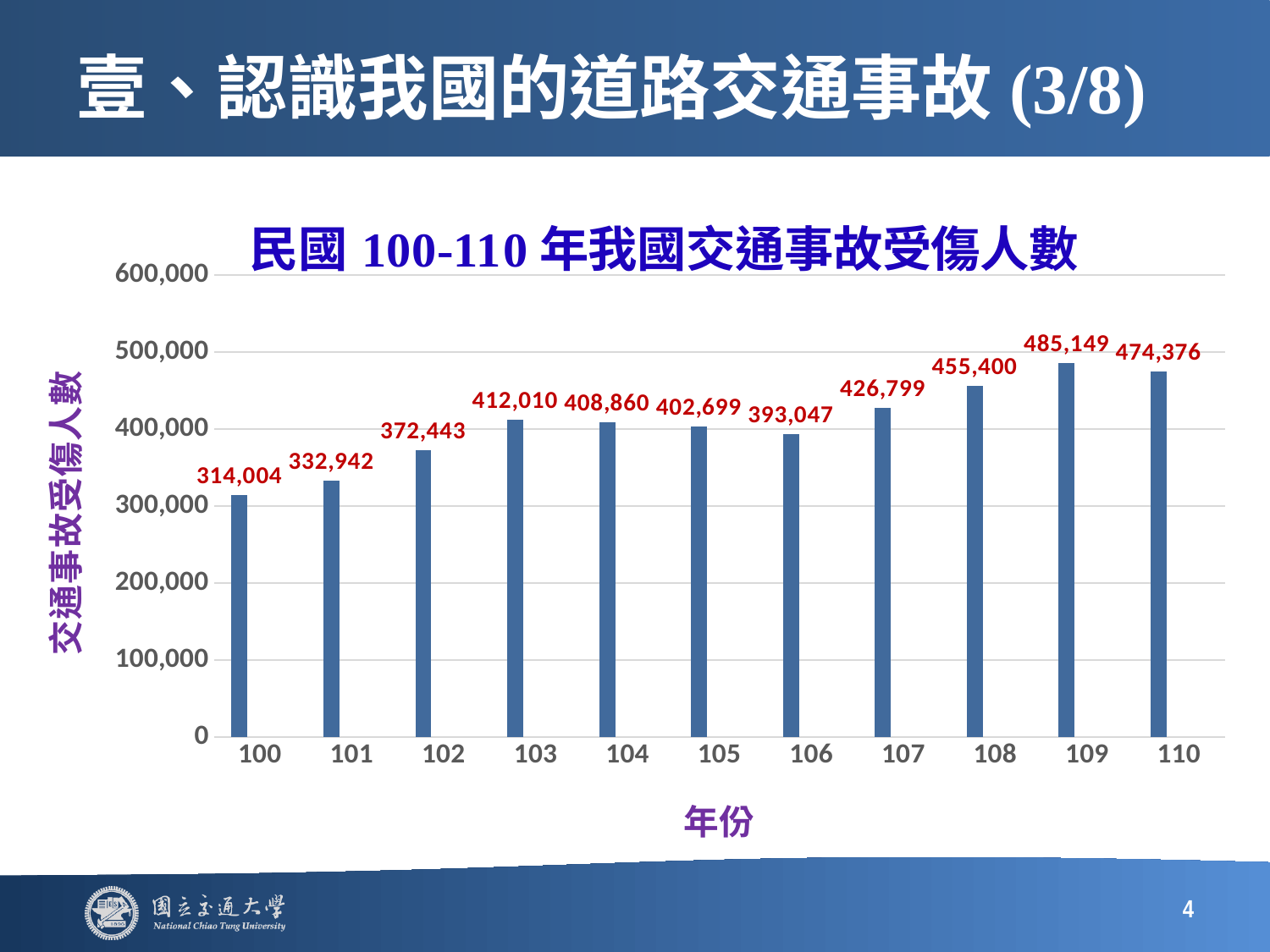
What is the title of the chart? 民國 100-110 年我國交通事故受傷人數 What is the difference in injuries between year 101 and year 100? 18,938 Which year has more injuries, 103 or 104? 103 How many years are shown on the x axis? 11 What is the number of traffic accident injuries for year 107? 426,799 Is the value for year 106 greater or less than 400,000? less What kind of chart is shown on the slide? bar chart What is the number of traffic accident injuries for year 100? 314,004 Which year has the highest number of traffic accident injuries? 109 Which year has the lowest number of traffic accident injuries? 100 What is the number of traffic accident injuries for year 110? 474,376 What is the difference in injuries between year 109 and year 110? 10,773